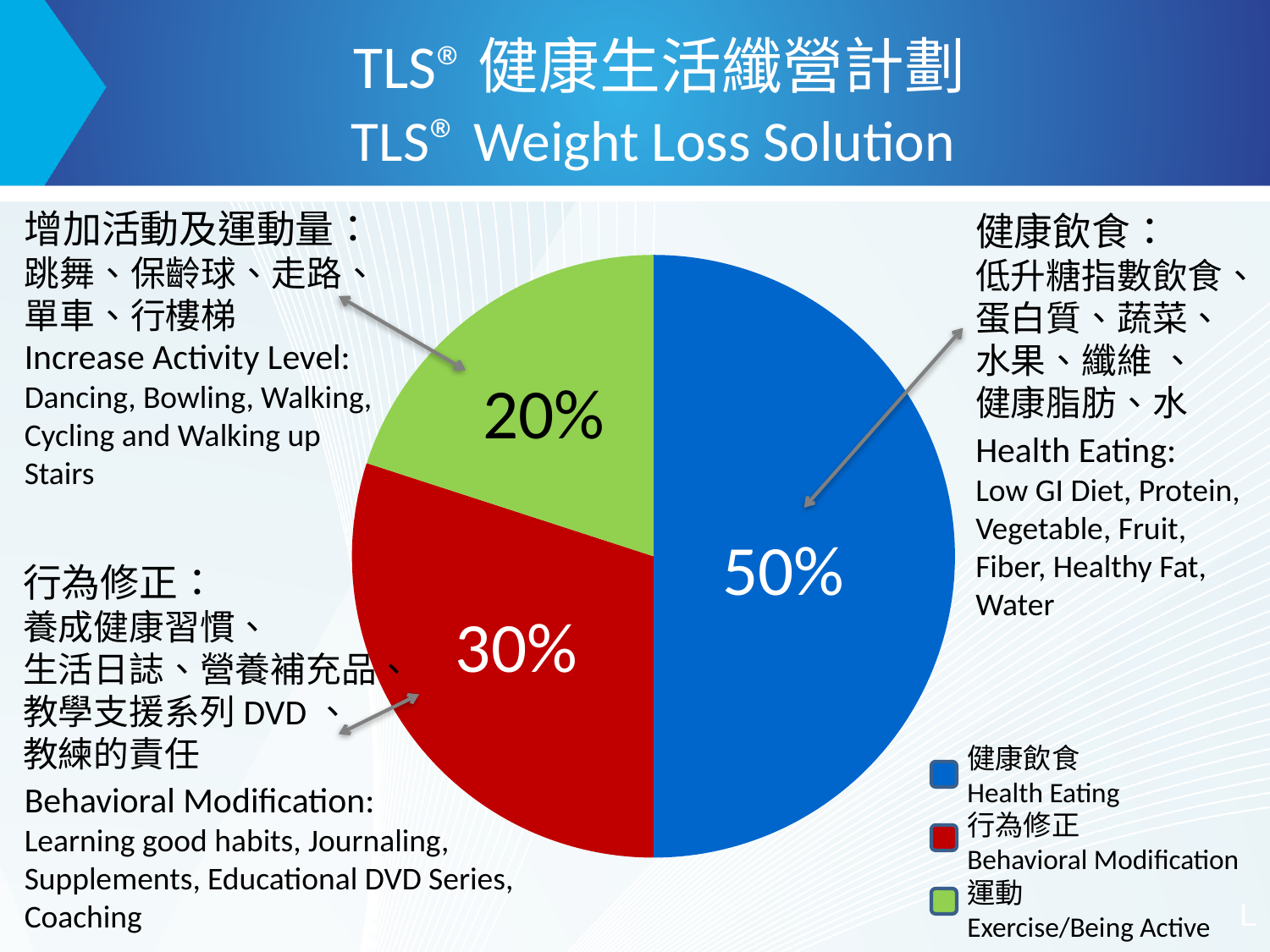
Which slice of the pie is the largest? Health Eating Which slice of the pie is the smallest? Exercise/Being Active What colour is the Health Eating slice in the pie chart? Blue What share of the pie does Behavioral Modification represent? 30% What type of chart is shown on the slide? Pie chart What share of the pie does Exercise/Being Active represent? 20% Which is larger, the Behavioral Modification slice or the Exercise/Being Active slice? Behavioral Modification How many entries does the legend list? 3 What share of the pie does Health Eating represent? 50% What is the difference in percentage points between the Behavioral Modification slice and the Exercise/Being Active slice? 10% How many slices does the pie chart have? 3 What is the difference in percentage points between the Health Eating slice and the Behavioral Modification slice? 20%